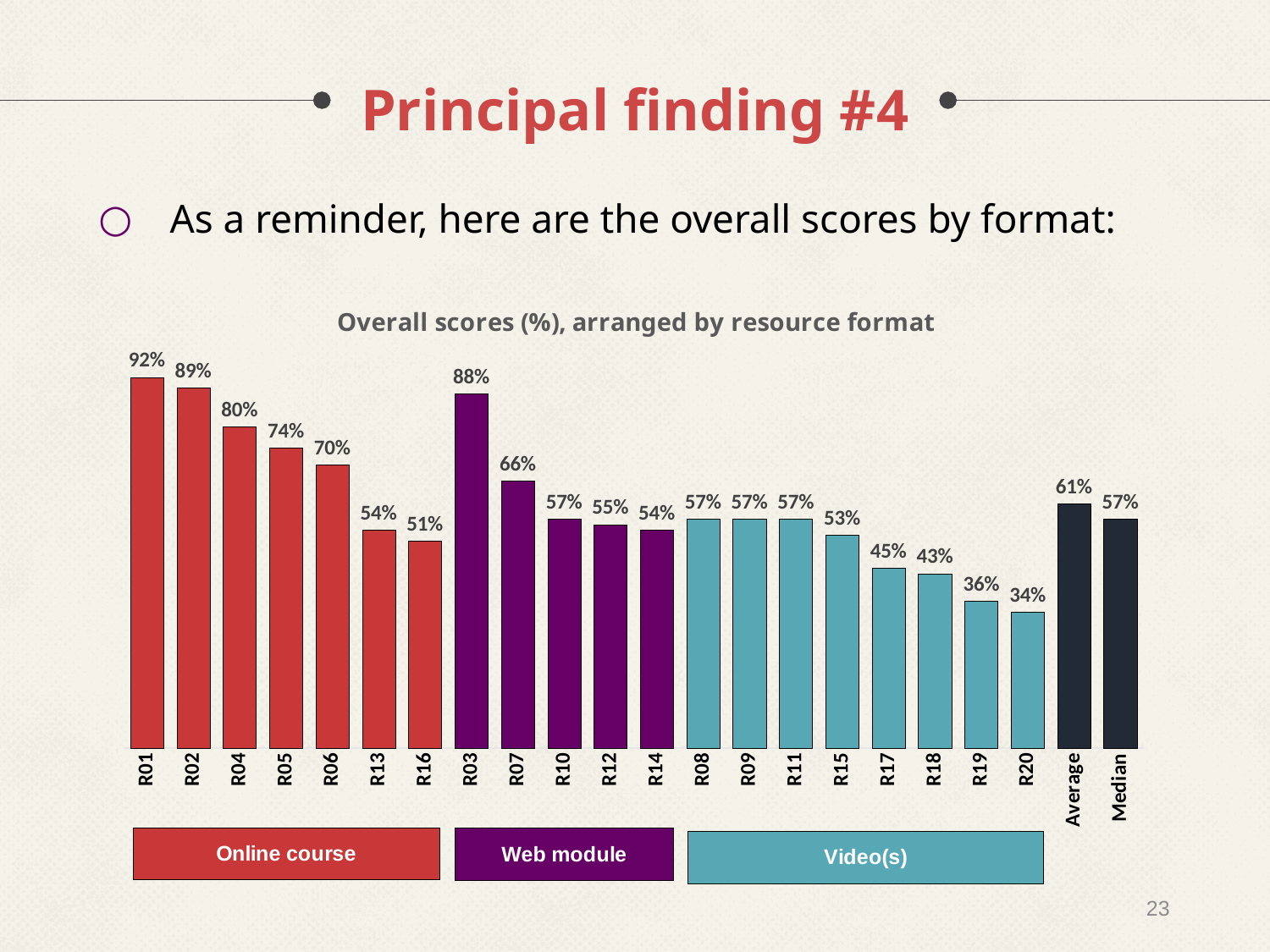
What is the difference between the overall scores of R01 and R02? 3% What is the overall score for R03? 88% What is the overall score for R01? 92% What is the overall score for R20? 34% Which has a higher overall score, R07 or R15? R07 What is the difference between the Average and Median values? 4% What is the title of the chart? Overall scores (%), arranged by resource format What is the value shown for the Average bar? 61% Which resource has the lowest overall score? R20 What type of chart is shown on the slide? Bar chart How many resources (R-labelled bars) are plotted in the chart? 20 Which resource has the highest overall score? R01